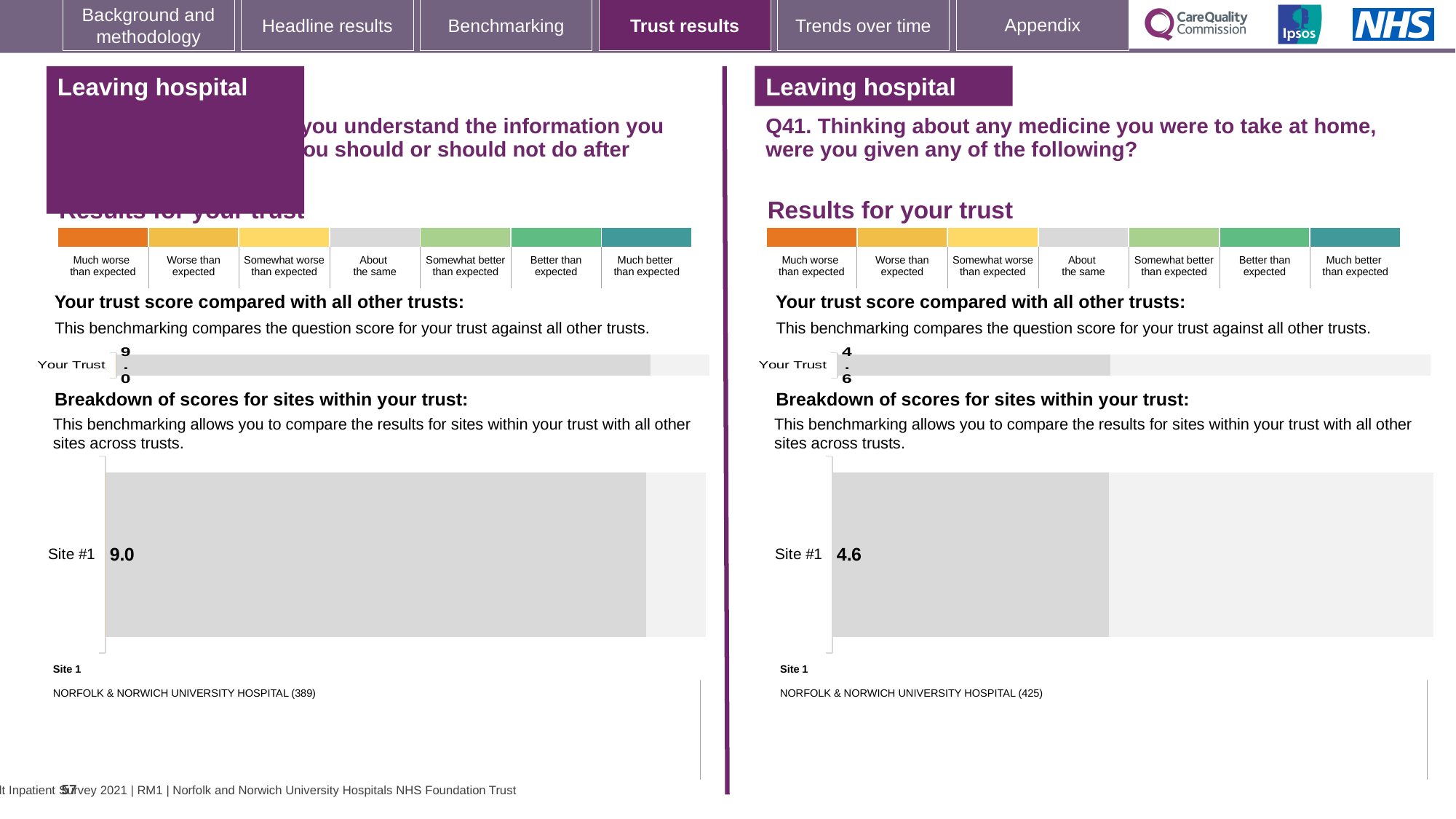
What kind of chart is used to show the Site #1 score on the right-hand breakdown chart? Bar chart According to the key below the right-hand (Q41) breakdown chart, which hospital is Site 1? Norfolk & Norwich University Hospital (425) How many sites are shown on the left-hand 'Breakdown of scores for sites within your trust' chart? 1 On the left-hand 'Breakdown of scores for sites within your trust' chart, what is the score shown for Site #1? 9.0 Which Site #1 score is larger: the one on the left-hand breakdown chart or the one on the right-hand (Q41) breakdown chart? The left-hand chart (9.0) How many sites are shown on the right-hand (Q41) 'Breakdown of scores for sites within your trust' chart? 1 On the right-hand 'Breakdown of scores for sites within your trust' chart (Q41), what is the score shown for Site #1? 4.6 What number appears in parentheses after the Site 1 hospital name below the left-hand breakdown chart? 389 What is the difference between the Site #1 score on the left-hand breakdown chart and the Site #1 score on the right-hand (Q41) breakdown chart? 4.4 On the left-hand breakdown chart, is the Site #1 score the same as the Your Trust score shown above it? Yes, both are 9.0 On the left-hand 'Your trust score compared with all other trusts' chart, what is the value shown for Your Trust? 9.0 On the right-hand 'Your trust score compared with all other trusts' chart (Q41), what is the value shown for Your Trust? 4.6